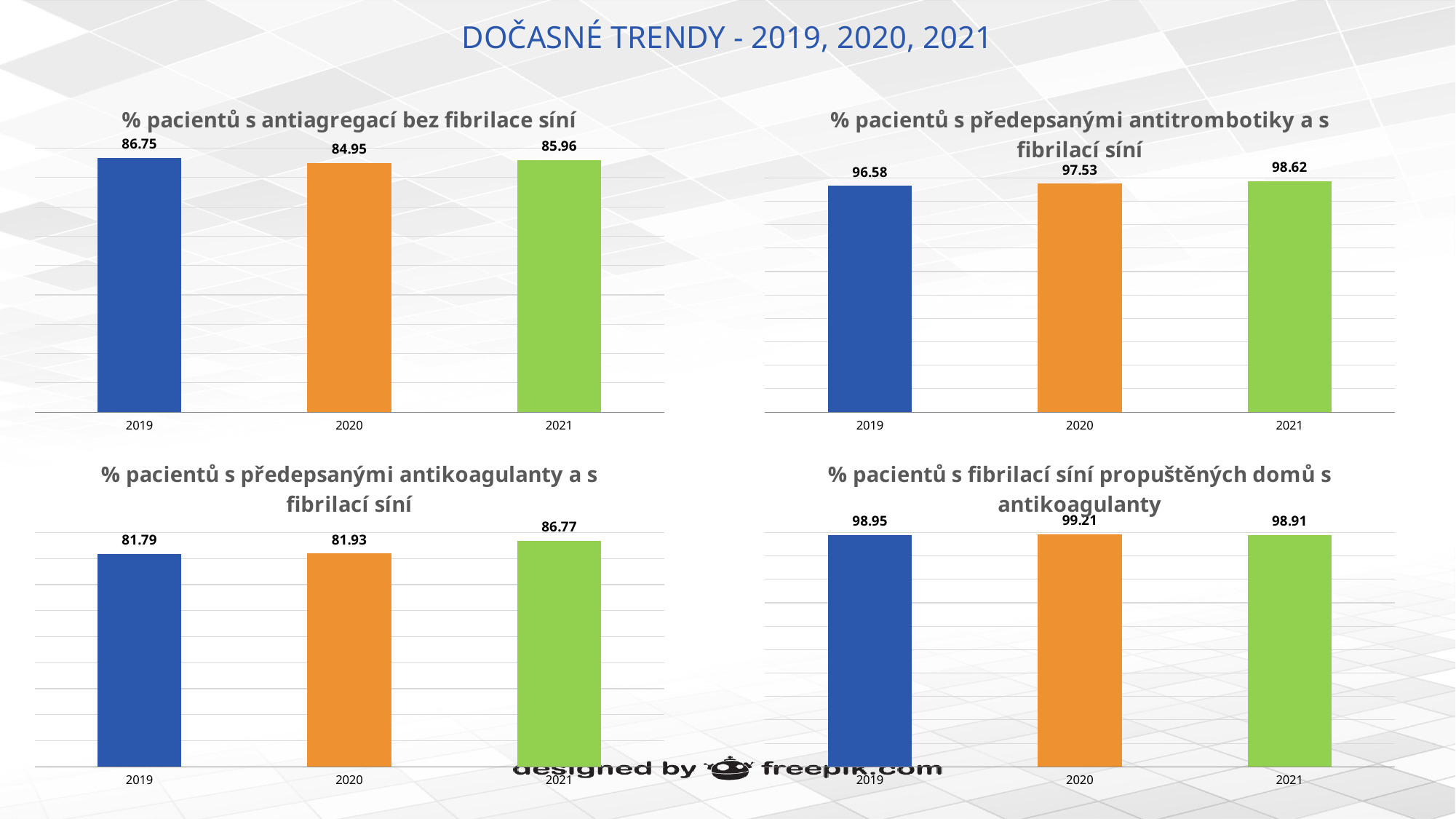
In the bottom-right chart (% pacientů s fibrilací síní propuštěných domů s antikoagulanty), what is the value for 2020? 99.21 In the bottom-left chart (% pacientů s předepsanými antikoagulanty a s fibrilací síní), what is the value for 2020? 81.93 What type of chart is the bottom-right chart (% pacientů s fibrilací síní propuštěných domů s antikoagulanty)? bar chart In the top-right chart (% pacientů s předepsanými antitrombotiky a s fibrilací síní), what is the value for 2021? 98.62 How many bars are shown in the top-left chart (% pacientů s antiagregací bez fibrilace síní)? 3 In the bottom-right chart (% pacientů s fibrilací síní propuštěných domů s antikoagulanty), which is larger, the value for 2019 or the value for 2021? 2019 In the top-left chart (% pacientů s antiagregací bez fibrilace síní), which year has the lowest value? 2020 In the top-right chart (% pacientů s předepsanými antitrombotiky a s fibrilací síní), do the values rise or fall from 2019 to 2021? rise In the bottom-left chart (% pacientů s předepsanými antikoagulanty a s fibrilací síní), which year has the highest value? 2021 In the top-left chart (% pacientů s antiagregací bez fibrilace síní), what is the value for 2019? 86.75 In the top-right chart (% pacientů s předepsanými antitrombotiky a s fibrilací síní), what is the difference between the 2021 and 2019 values? 2.04 In the bottom-left chart (% pacientů s předepsanými antikoagulanty a s fibrilací síní), what is the difference between the 2021 and 2019 values? 4.98